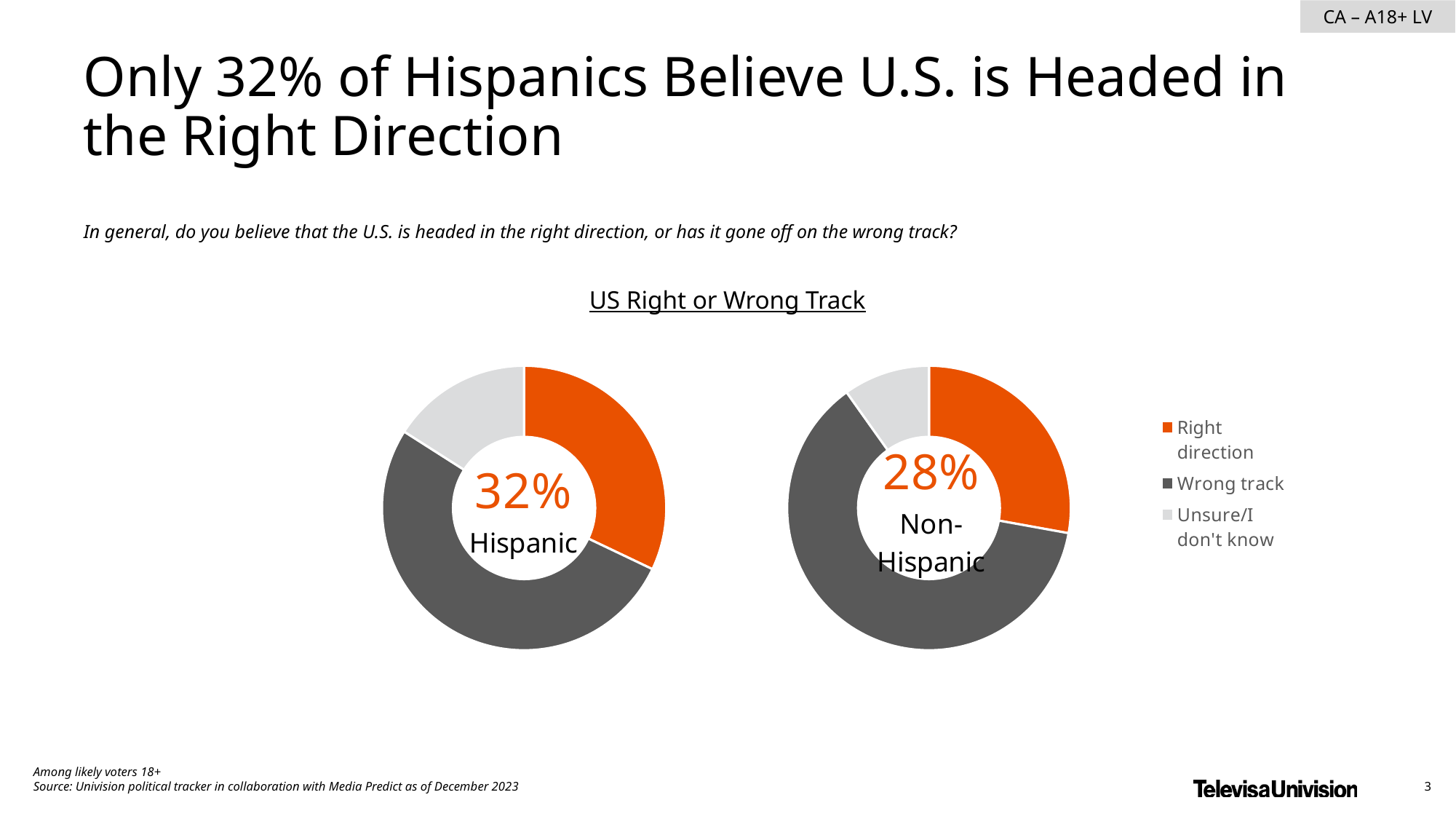
In the Non-Hispanic donut chart, which response has the largest slice? Wrong track How many donut charts are shown on the slide? 2 In the Non-Hispanic donut chart, what percentage chose Right direction? 28% How many entries does the legend list for the US Right or Wrong Track charts? 3 How many percentage points higher is the Right direction share for Hispanics than for Non-Hispanics? 4 percentage points What kind of chart is used to show the US Right or Wrong Track results? Donut (pie) chart In the Hispanic donut chart, what percentage chose Right direction? 32% Which group has the larger Right direction share, Hispanic or Non-Hispanic? Hispanic In the Hispanic donut chart, which response has the largest slice? Wrong track What is the title shown above the donut charts? US Right or Wrong Track In the Non-Hispanic donut chart, which response has the smallest slice? Unsure/I don't know In the Hispanic donut chart, which response has the smallest slice? Unsure/I don't know